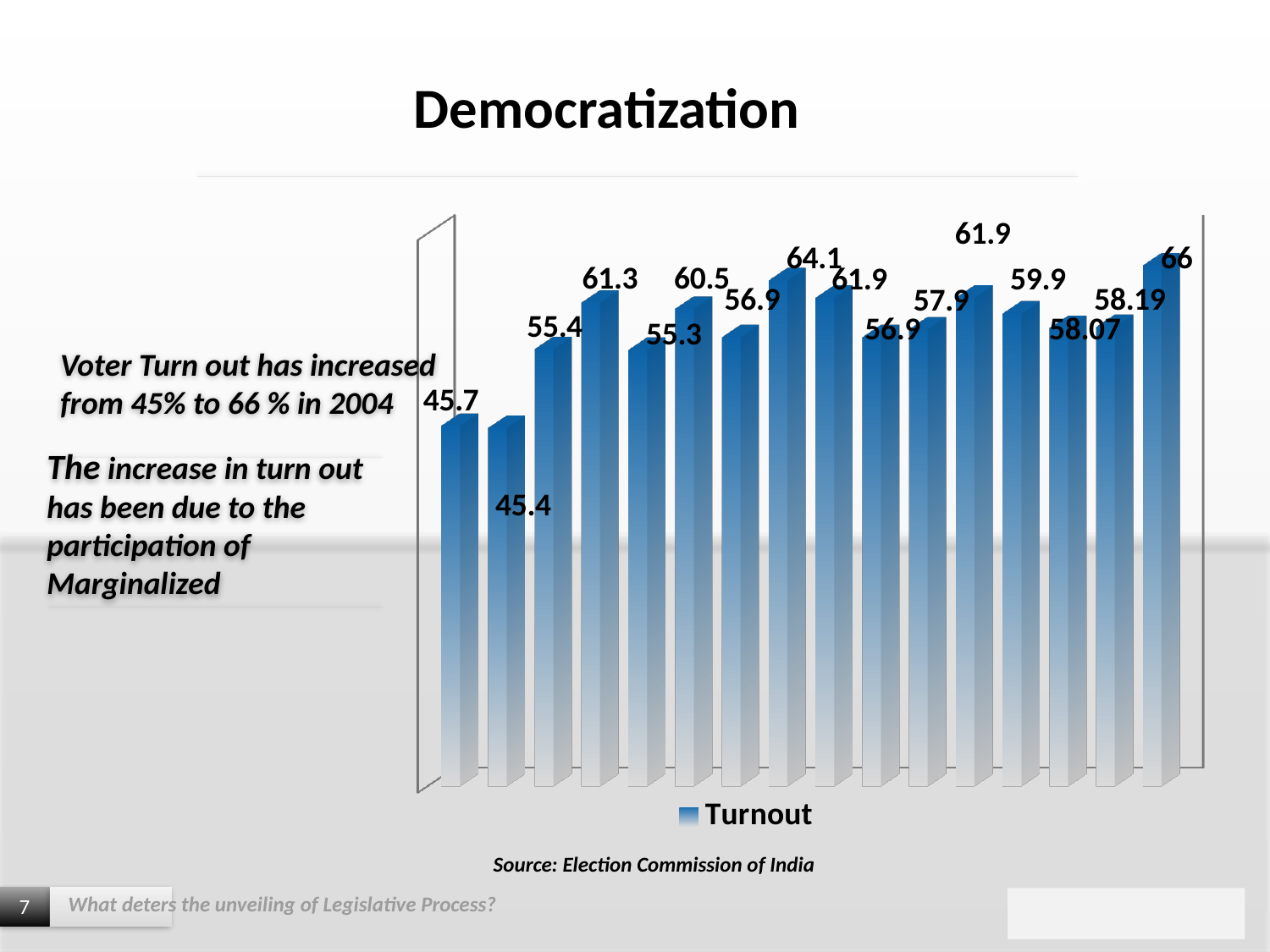
What is the value of the first (leftmost) bar in the chart? 45.7 Which is larger, the bar labelled 64.1 or the bar labelled 61.3? 64.1 What is the value of the last (rightmost) bar in the chart? 66 How many series does the chart legend list? 1 What is the difference between the highest value (66) and the lowest value (45.4) in the chart? 20.6 What is the highest value shown in the chart? 66 What kind of chart is shown on the slide? bar chart How many bars are plotted in the chart? 16 What is the name of the series shown in the chart legend? Turnout Overall, do the turnout values rise or fall from the leftmost bar to the rightmost bar? rise What is the lowest value shown in the chart? 45.4 What is the difference between the last bar (66) and the first bar (45.7)? 20.3